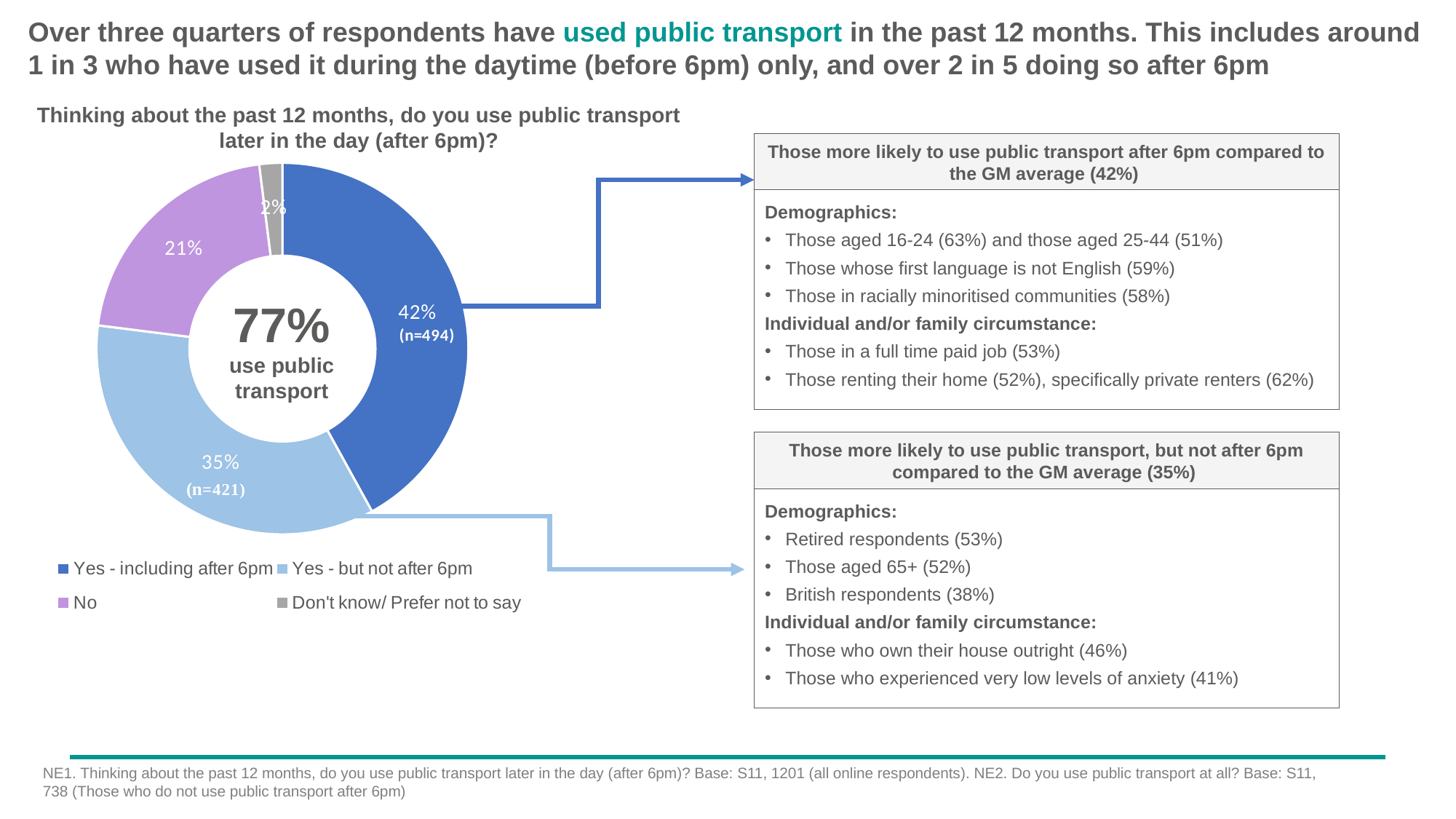
Which category has the largest share of the chart? Yes - including after 6pm How many categories does the legend list? 4 What is the sample size (n) shown for the 'Yes - including after 6pm' segment? n=494 What percentage is shown in the centre of the doughnut chart? 77% What percentage of respondents answered 'Don't know/ Prefer not to say'? 2% What kind of chart is shown on the slide? Doughnut chart Which category has the smallest share of the chart? Don't know/ Prefer not to say What percentage of respondents answered 'Yes - but not after 6pm'? 35% What percentage of respondents answered 'Yes - including after 6pm'? 42% What percentage of respondents answered 'No'? 21% What is the difference in percentage points between 'Yes - including after 6pm' and 'Yes - but not after 6pm'? 7 percentage points Which is larger: the share for 'No' or the share for 'Yes - but not after 6pm'? Yes - but not after 6pm